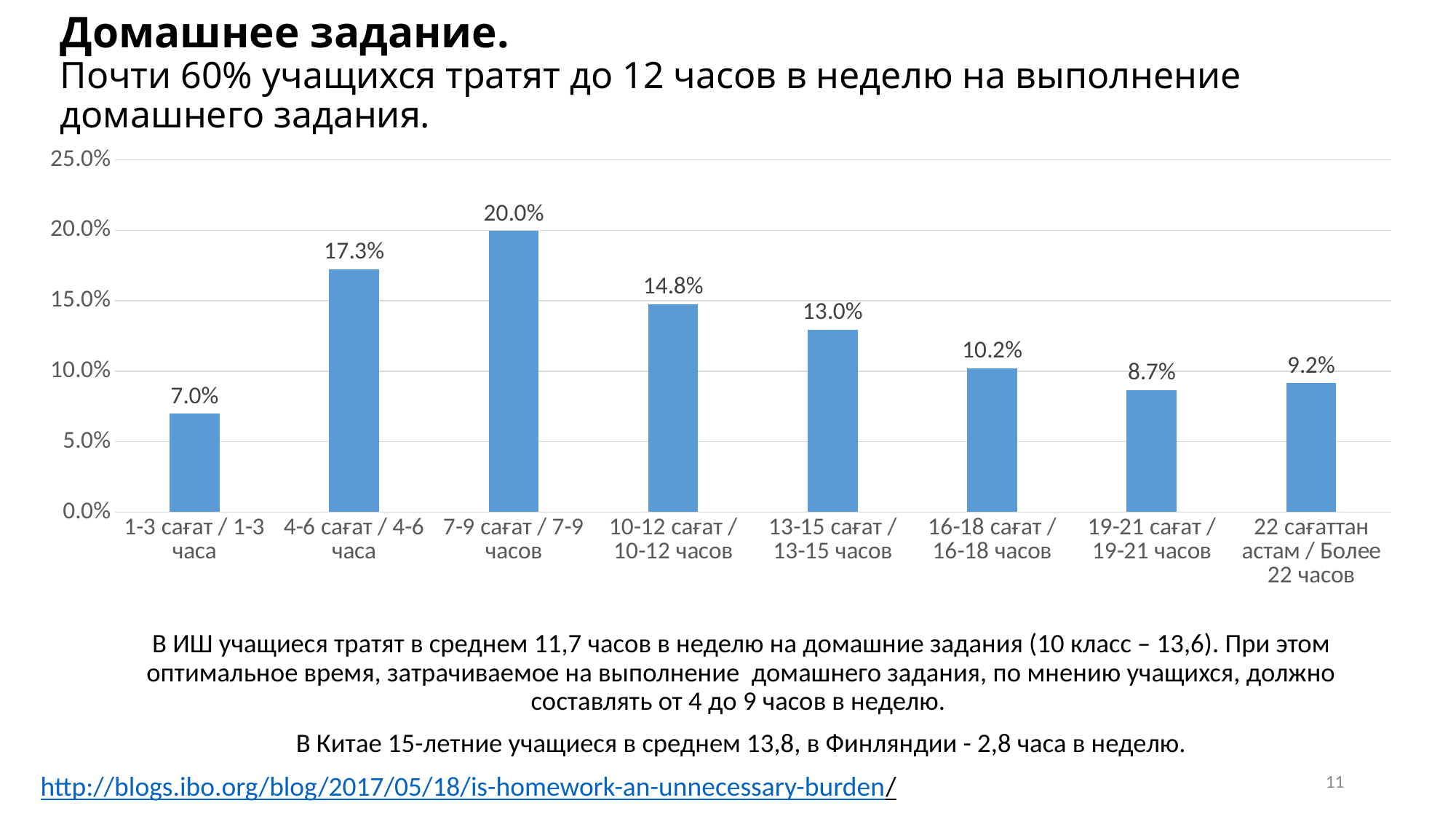
What is the difference between the values for 4-6 сағат / 4-6 часа and 10-12 сағат / 10-12 часов? 2.5% How many categories are shown on the x axis? 8 What is the value for the 1-3 сағат / 1-3 часа category? 7.0% Do the values rise or fall from 7-9 сағат / 7-9 часов to 19-21 сағат / 19-21 часов? fall Which category has the highest value? 7-9 сағат / 7-9 часов What kind of chart is shown on the slide? bar chart Is the value for 13-15 сағат / 13-15 часов greater or less than 15.0%? less Which category has the lowest value? 1-3 сағат / 1-3 часа What is the value for the 7-9 сағат / 7-9 часов category? 20.0% What is the value for the 22 сағаттан астам / Более 22 часов category? 9.2% What is the highest value shown on the y axis? 25.0% Which is larger, the value for 19-21 сағат / 19-21 часов or the value for 22 сағаттан астам / Более 22 часов? 22 сағаттан астам / Более 22 часов